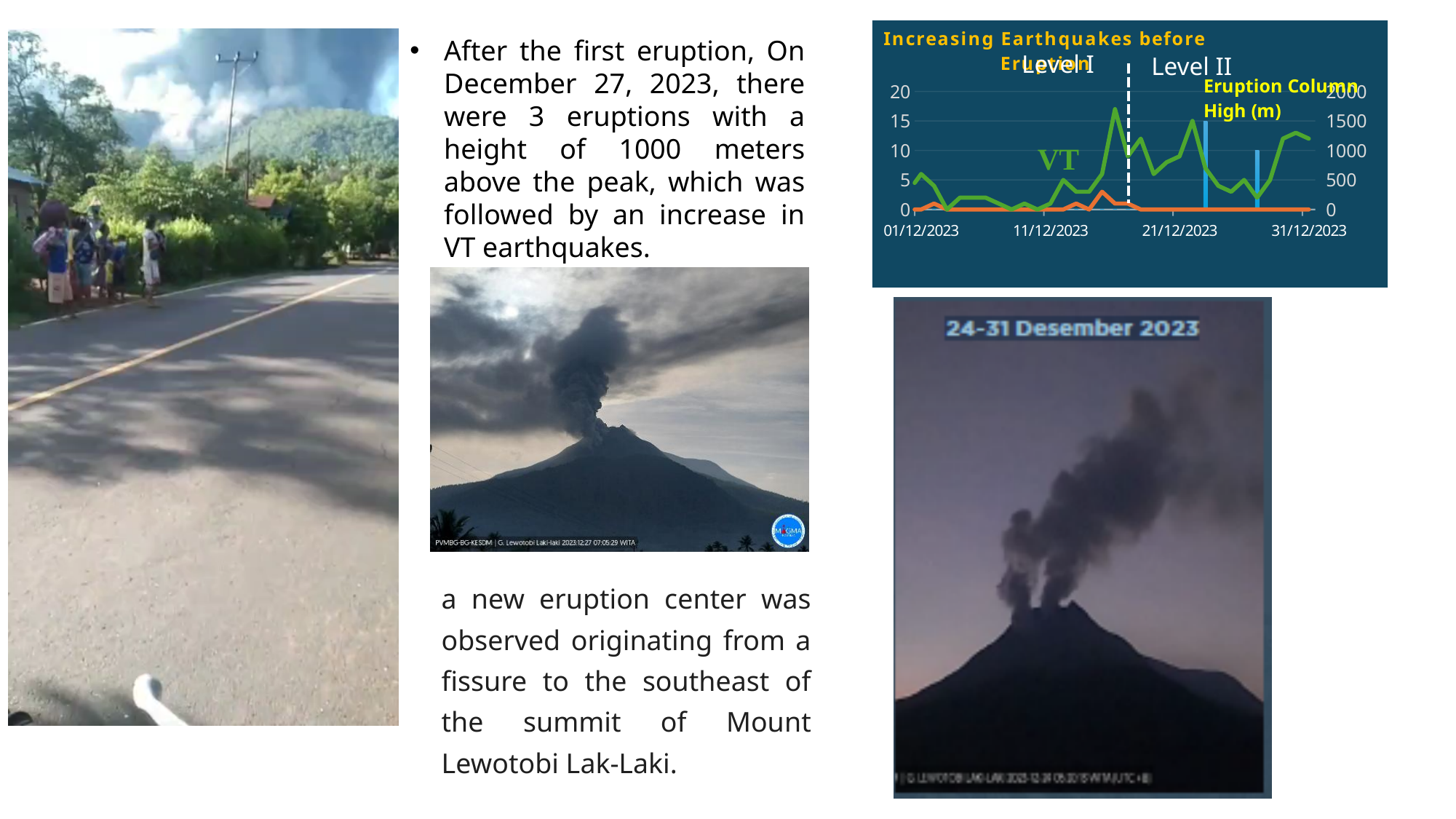
Which line reaches higher values on the chart, the green VT line or the orange line? the green VT line What is the first date label on the x axis of the chart? 01/12/2023 Is the peak value of the green VT line greater or less than 15? greater What is the title of the chart on the slide? Increasing Earthquakes before Eruption Is the value of the green VT line at 01/12/2023 greater or less than 10? less What is the last date label on the x axis of the chart? 31/12/2023 What is the highest tick value shown on the left vertical axis of the chart? 20 What kind of chart is 'Increasing Earthquakes before Eruption'? combination bar and line chart What quantity does the right vertical axis of the chart represent? Eruption Column High (m) Does the green VT line generally rise or fall from the start of December to the end of December? rise How many date labels are shown on the x axis of the chart? 4 What is the highest tick value shown on the right vertical axis of the chart? 2000